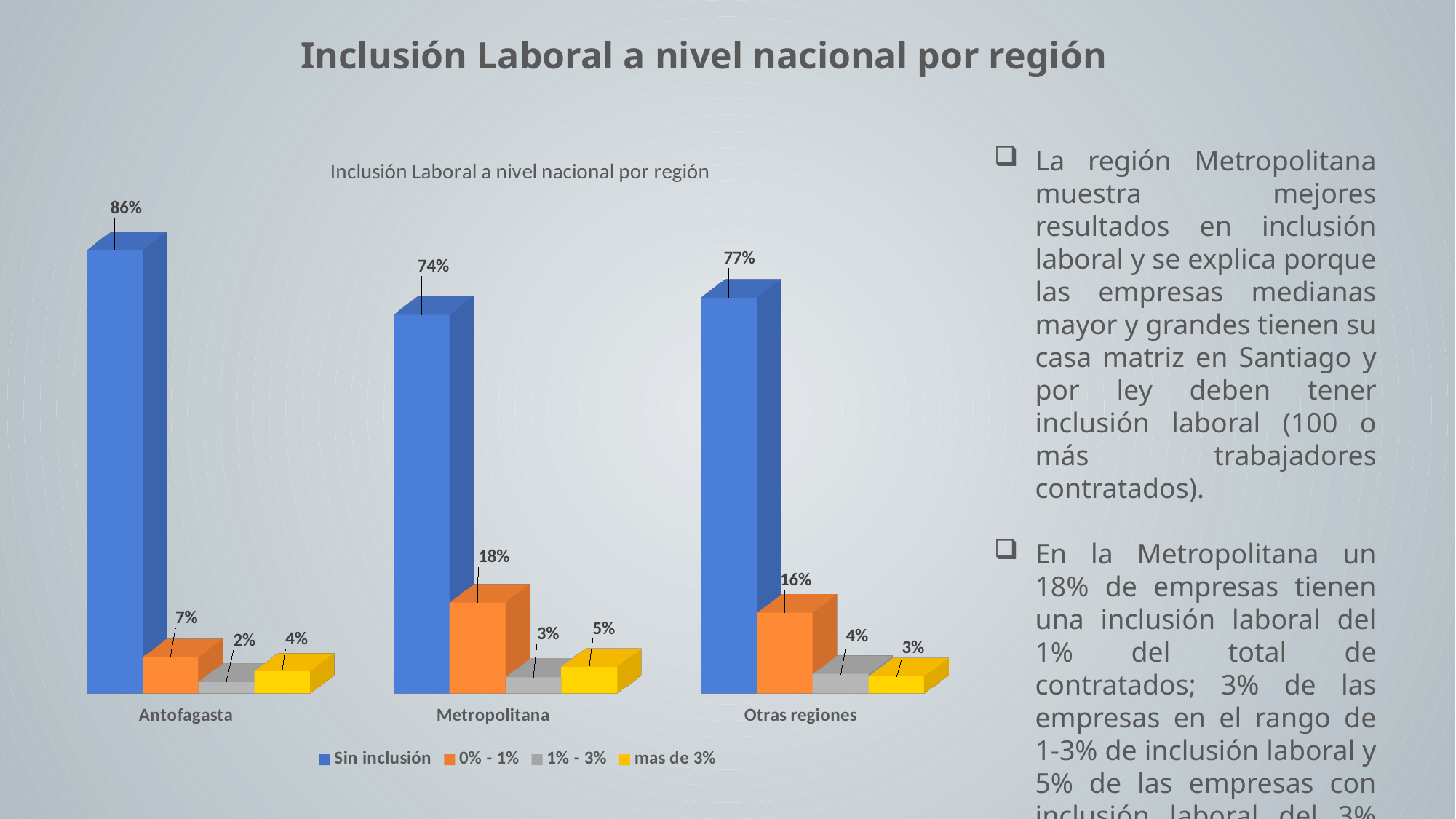
How many series does the legend list? 4 What is the value for 'Sin inclusión' in Antofagasta? 86% Which series is shown in yellow in the legend? mas de 3% What is the value for '1% - 3%' in Antofagasta? 2% What is the value for '0% - 1%' in Metropolitana? 18% What is the value for 'mas de 3%' in Otras regiones? 3% How many regions (categories) are shown on the x axis? 3 What is the difference between the 'Sin inclusión' values for Antofagasta and Metropolitana? 12% Which is larger: the '0% - 1%' value for Metropolitana or for Otras regiones? Metropolitana Which region has the highest value for 'Sin inclusión'? Antofagasta Which region has the lowest value for 'Sin inclusión'? Metropolitana What kind of chart is shown on the slide? Bar chart